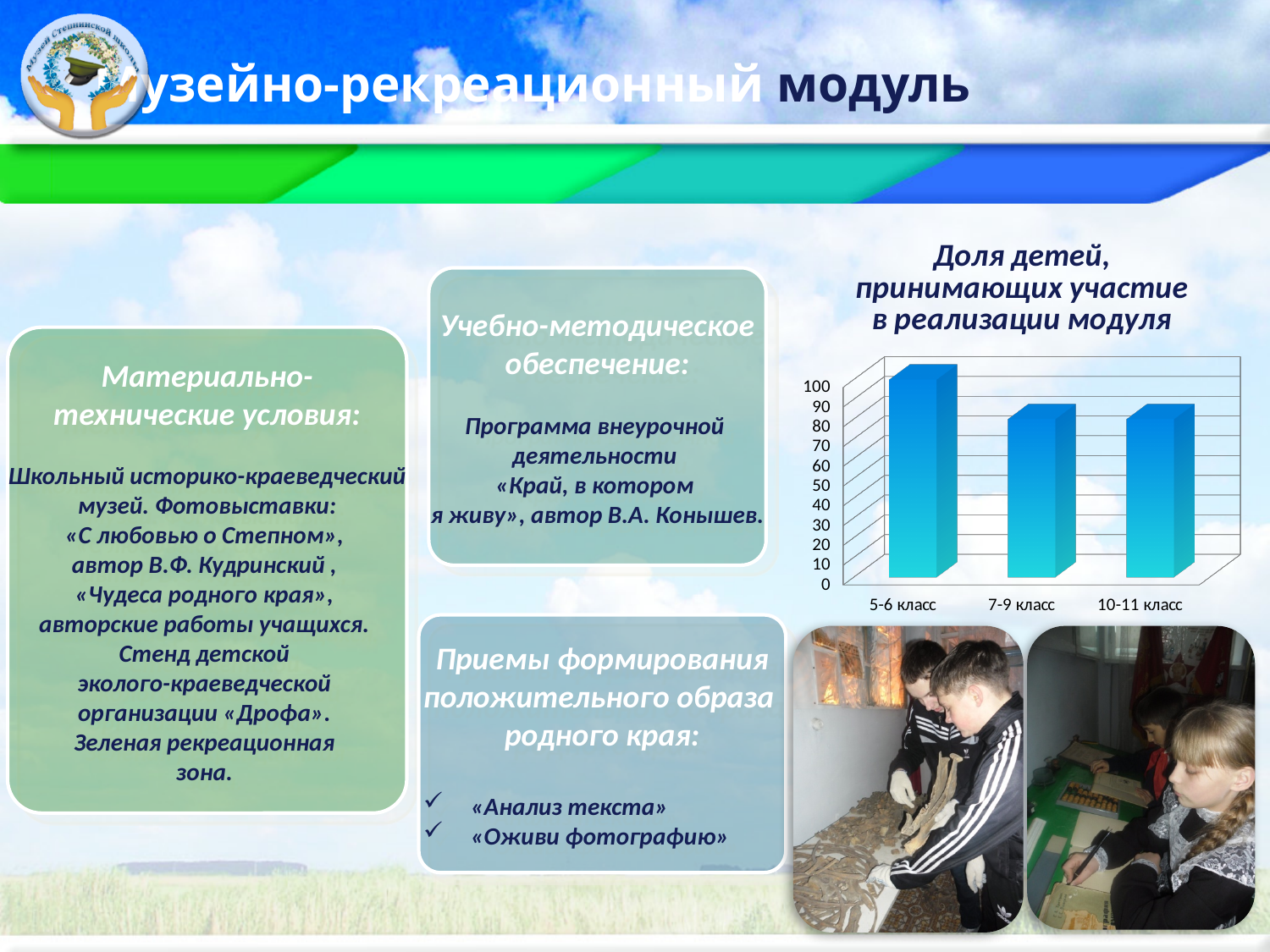
Which is larger, the value for 5-6 класс or the value for 10-11 класс? 5-6 класс Is the value for 10-11 класс greater or less than 50? greater What is the highest value shown on the chart's vertical axis? 100 Which category has the highest value in the chart? 5-6 класс Is the value for 5-6 класс greater or less than 80? greater Which is larger, the value for 5-6 класс or the value for 7-9 класс? 5-6 класс Is the value for 7-9 класс greater or less than 100? less What is the title of the chart? Доля детей, принимающих участие в реализации модуля What kind of chart is shown on the slide? bar chart How many categories are shown on the x axis of the chart? 3